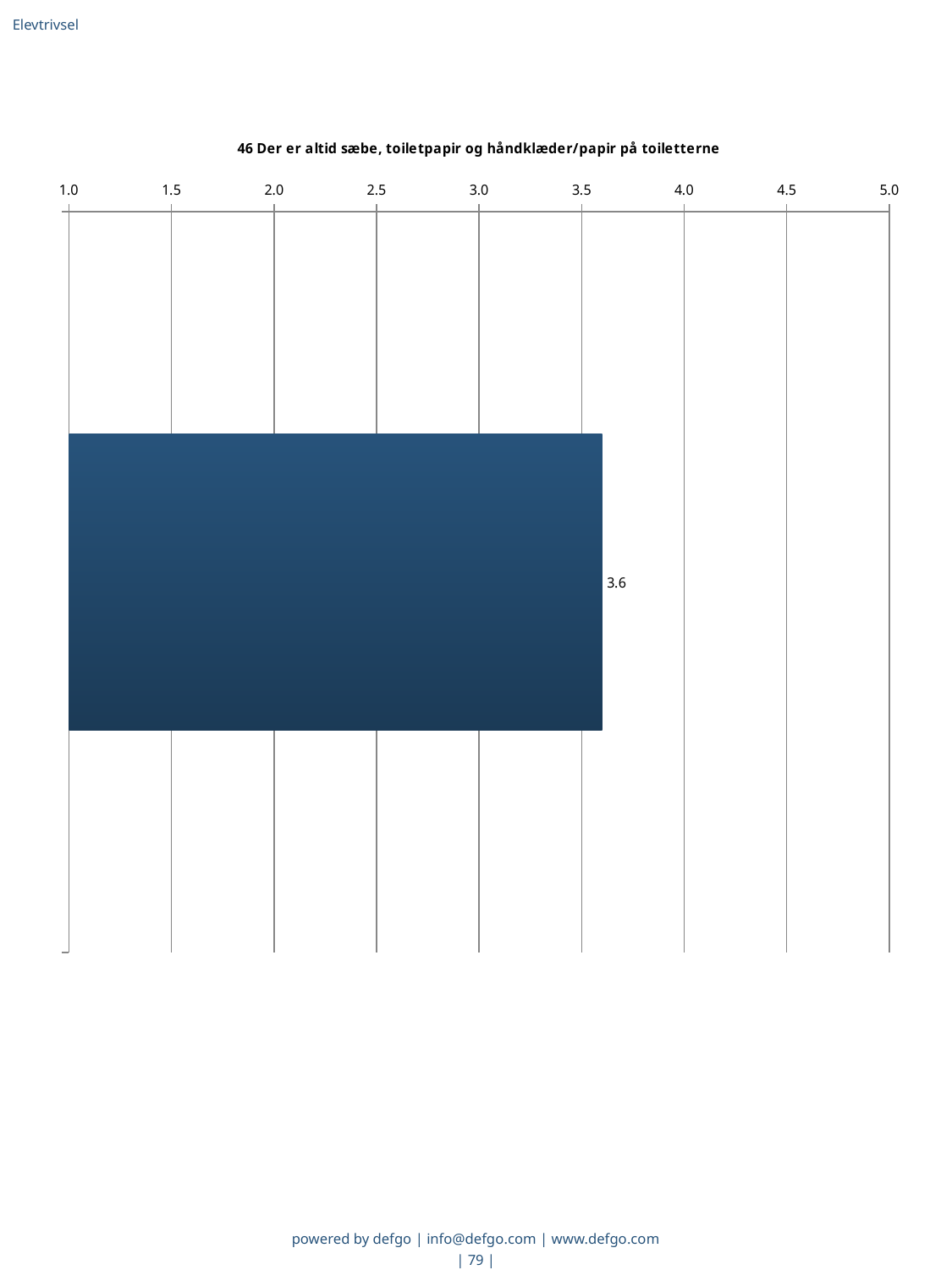
Is the value of the bar greater or less than 3.0? greater How many bars are plotted in the chart? 1 What is the title of the chart? 46 Der er altid sæbe, toiletpapir og håndklæder/papir på toiletterne What is the highest value shown on the chart's axis? 5.0 What kind of chart is shown on the slide? bar chart Is the value of the bar greater or less than 4.0? less What value is shown by the bar in the chart? 3.6